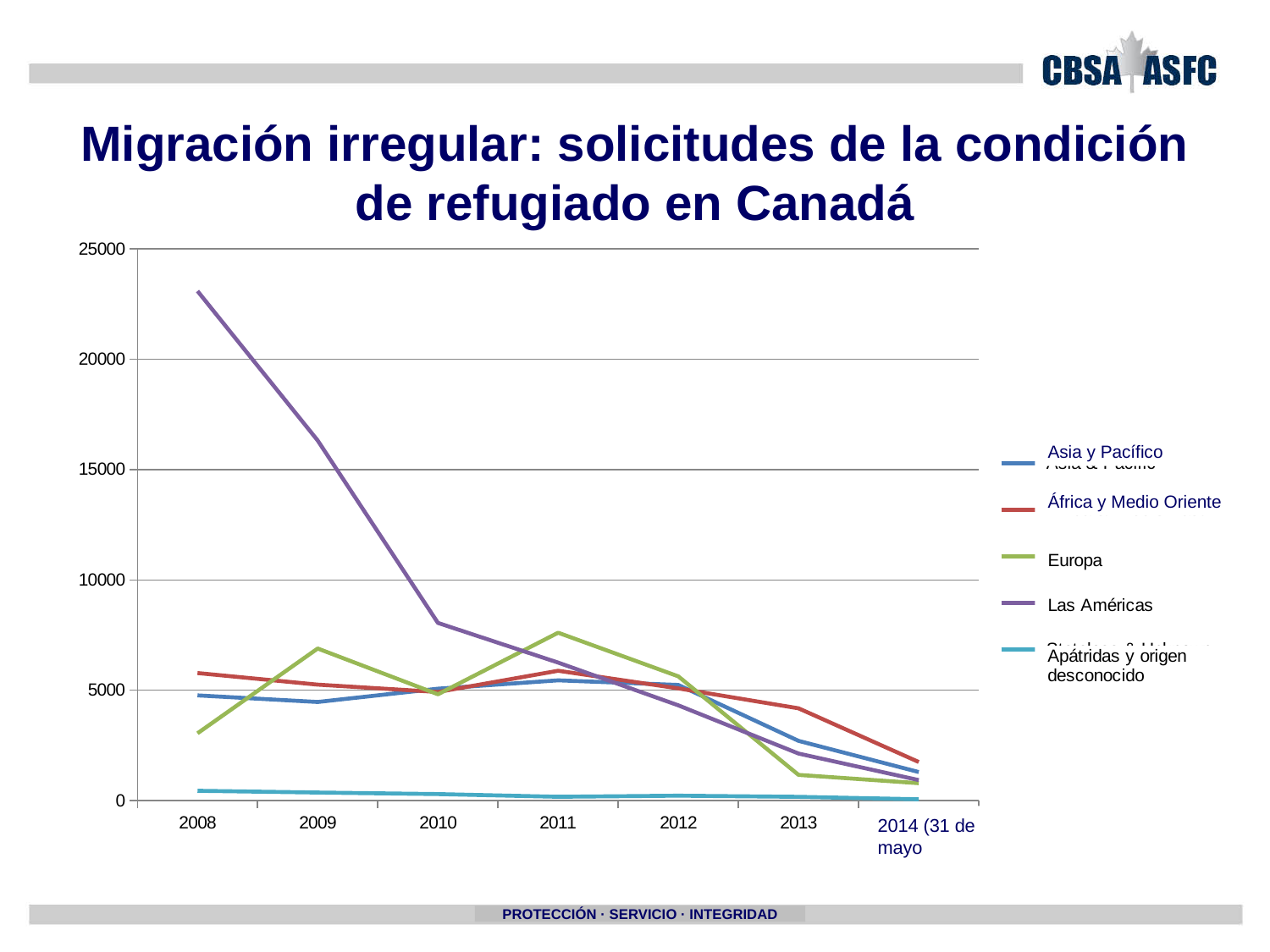
How many series does the legend list? 5 Is the value for Europa in 2008 greater or less than 5000? less How many points are there along the x axis? 7 Which series has the lowest value in 2008? Apátridas y origen desconocido In 2008, which is larger: the value for Las Américas or the value for Europa? Las Américas Which series has the highest value in 2008? Las Américas What is the title of the chart on the slide? Migración irregular: solicitudes de la condición de refugiado en Canadá What kind of chart is shown on the slide? Line chart In 2013, which is larger: the value for África y Medio Oriente or the value for Europa? África y Medio Oriente Does the value for Las Américas rise or fall from 2008 to 2014? fall Is the value for Las Américas in 2010 greater or less than 5000? greater Is the value for Las Américas in 2008 greater or less than 20000? greater